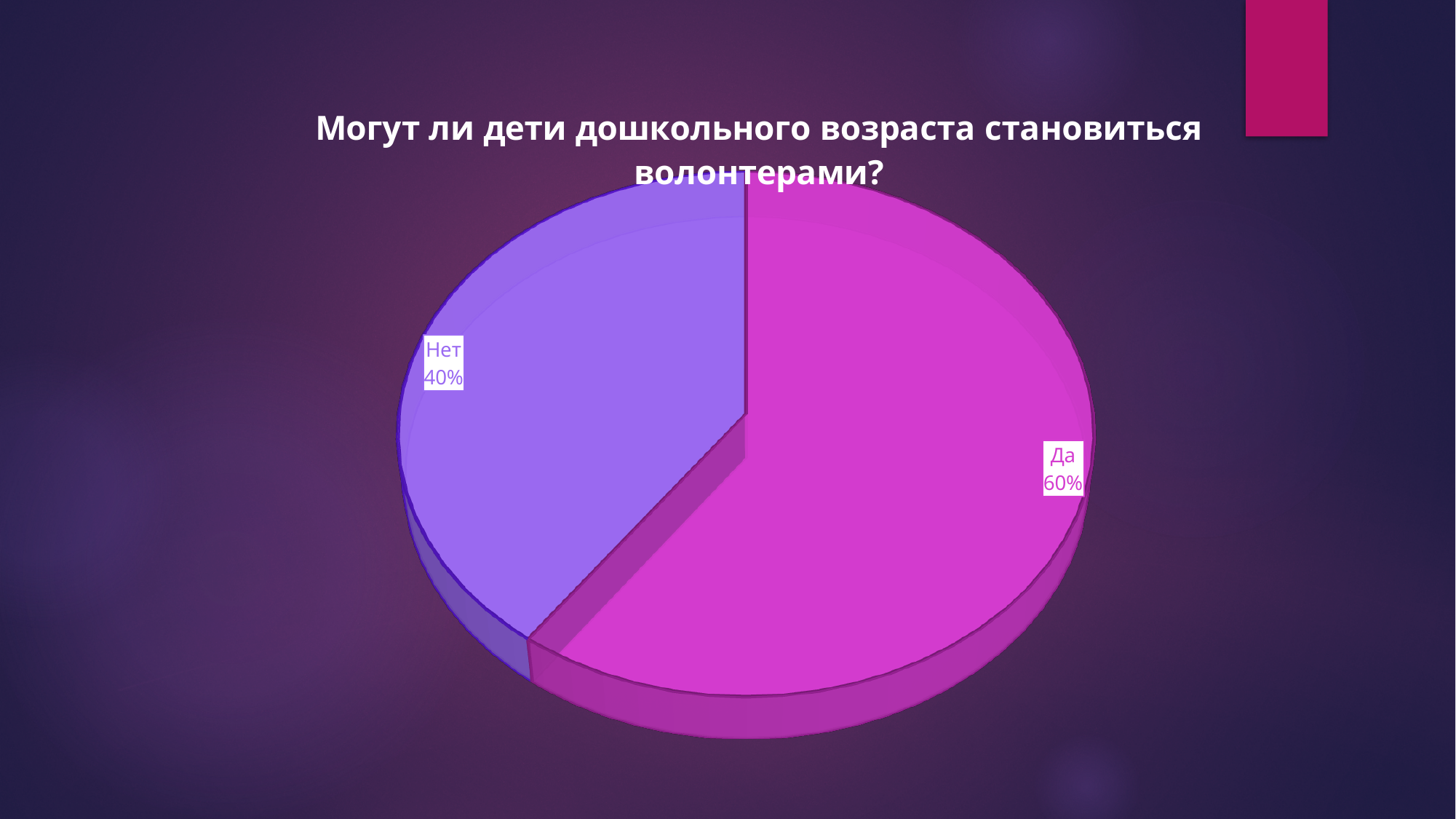
Which is larger, the "Да" slice or the "Нет" slice? Да What colour is the "Нет" slice? purple What is the difference in percentage points between the "Да" and "Нет" slices? 20% What share of the pie does the "Да" slice represent? 60% What share of the pie does the "Нет" slice represent? 40% What is the title of the chart? Могут ли дети дошкольного возраста становиться волонтерами? What kind of chart is shown on the slide? pie chart How many slices does the pie chart have? 2 Which slice is the largest? Да Which slice is the smallest? Нет